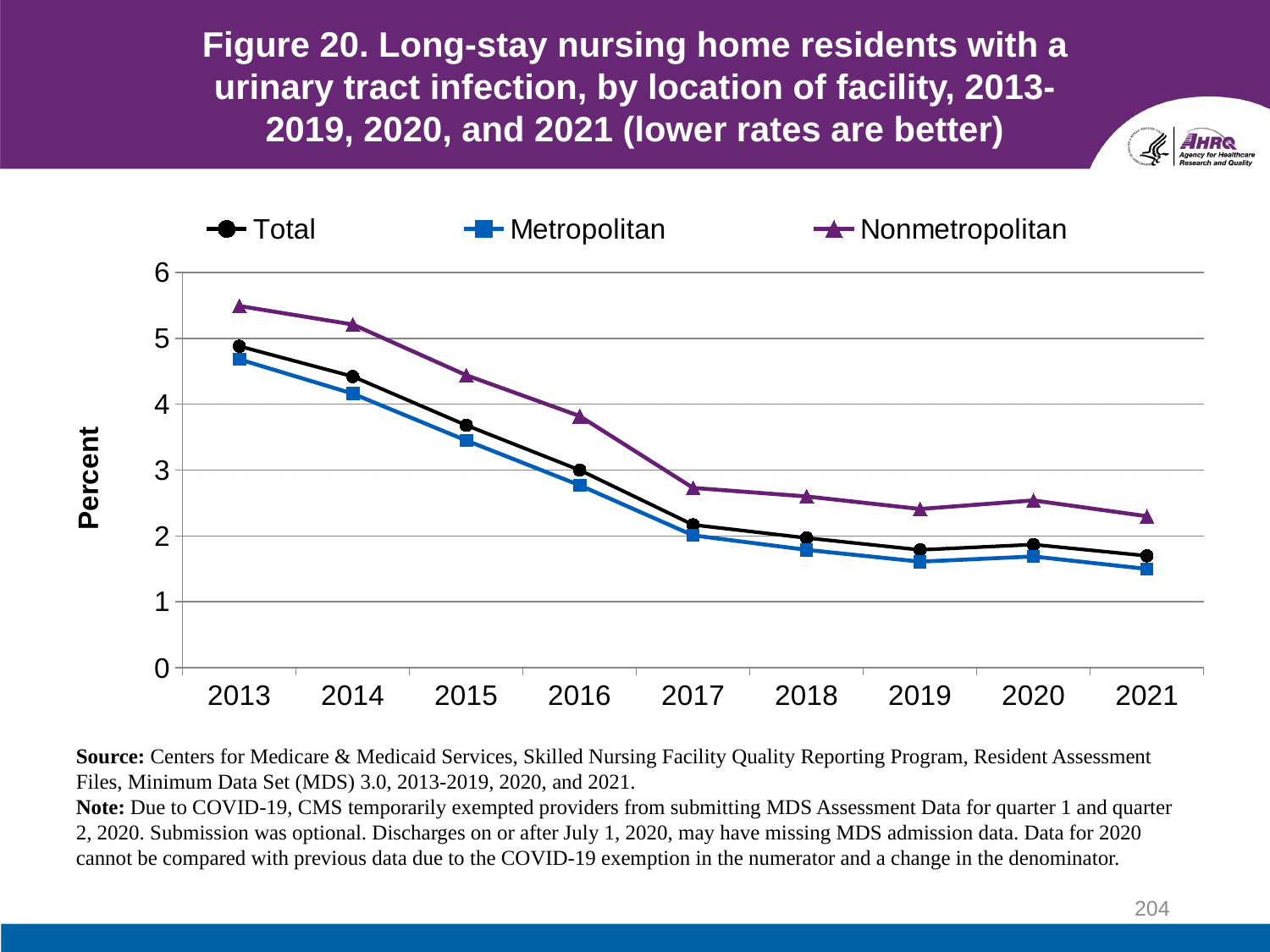
Is the value for Nonmetropolitan in 2013 greater or less than 5? greater How many years are plotted along the x axis? 9 Which series has the highest value in 2013? Nonmetropolitan Is the value for Metropolitan in 2021 greater or less than 2? less Is the value for Nonmetropolitan in 2017 greater or less than 3? less Which series has the lowest value in 2021? Metropolitan What kind of chart is shown on the slide? line chart Which is larger in 2016, the Nonmetropolitan value or the Metropolitan value? Nonmetropolitan How many series does the legend list? 3 In which year is the Total series at its highest? 2013 Do the values for the Total series generally rise or fall from 2013 to 2021? fall